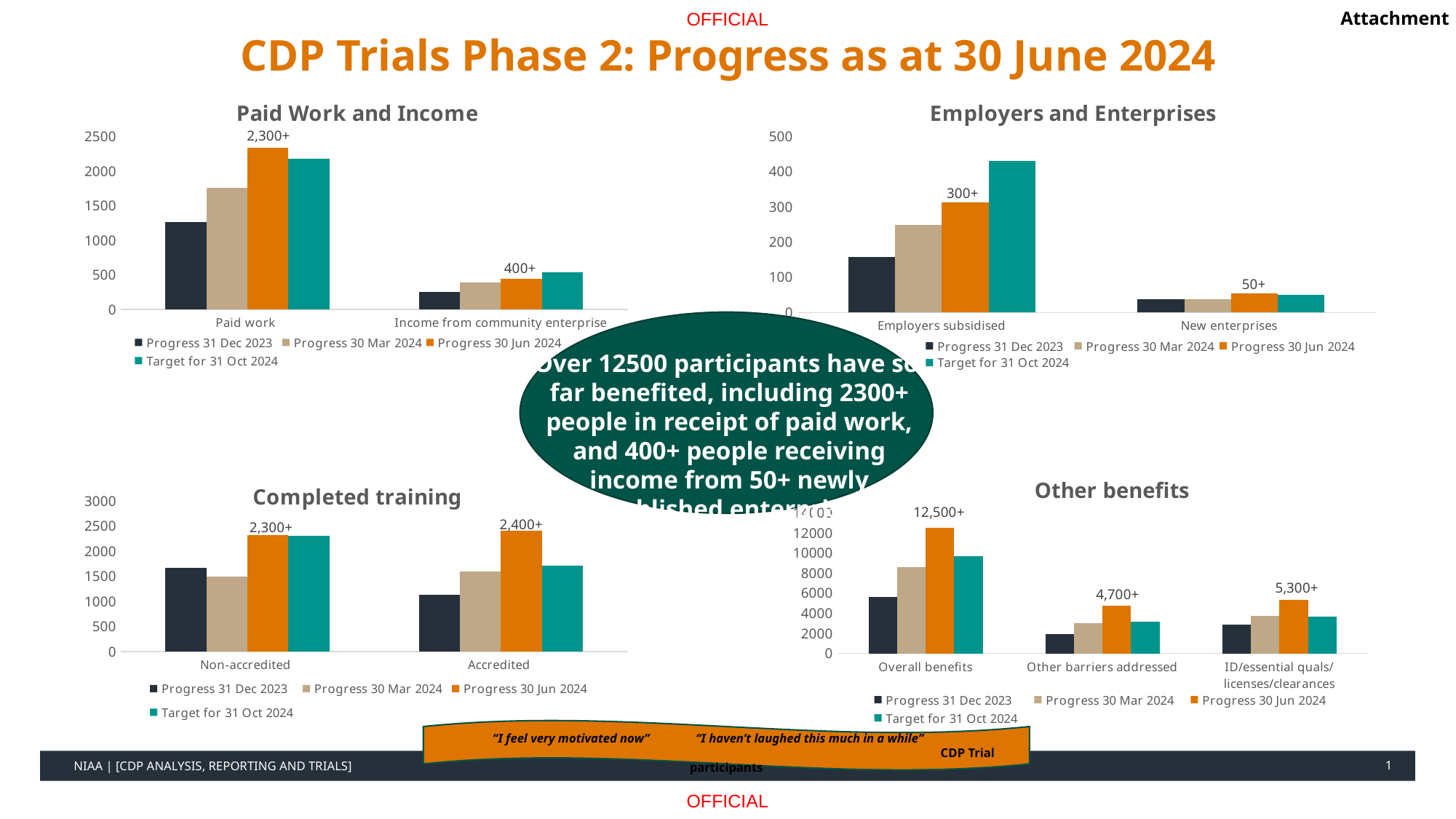
In the Completed training chart, what is the labelled value for Accredited for Progress 30 Jun 2024? 2,400+ In the Employers and Enterprises chart, is the Target for 31 Oct 2024 value for Employers subsidised greater or less than 400? greater How many series does the legend of the Paid Work and Income chart list? 4 In the Paid Work and Income chart, what is the labelled value for Paid work for Progress 30 Jun 2024? 2,300+ In the Paid Work and Income chart, what is the labelled value for Income from community enterprise for Progress 30 Jun 2024? 400+ In the Completed training chart, is the Progress 31 Dec 2023 value for Accredited greater or less than 1000? greater In the Employers and Enterprises chart, what is the labelled value for New enterprises for Progress 30 Jun 2024? 50+ In the Other benefits chart, which is larger for Overall benefits: Progress 30 Jun 2024 or Target for 31 Oct 2024? Progress 30 Jun 2024 In the Other benefits chart, what is the labelled value for Other barriers addressed for Progress 30 Jun 2024? 4,700+ How many categories are shown on the x axis of the Other benefits chart? 3 In the Employers and Enterprises chart, what is the labelled value for Employers subsidised for Progress 30 Jun 2024? 300+ In the Other benefits chart, which category has the highest Progress 30 Jun 2024 value? Overall benefits